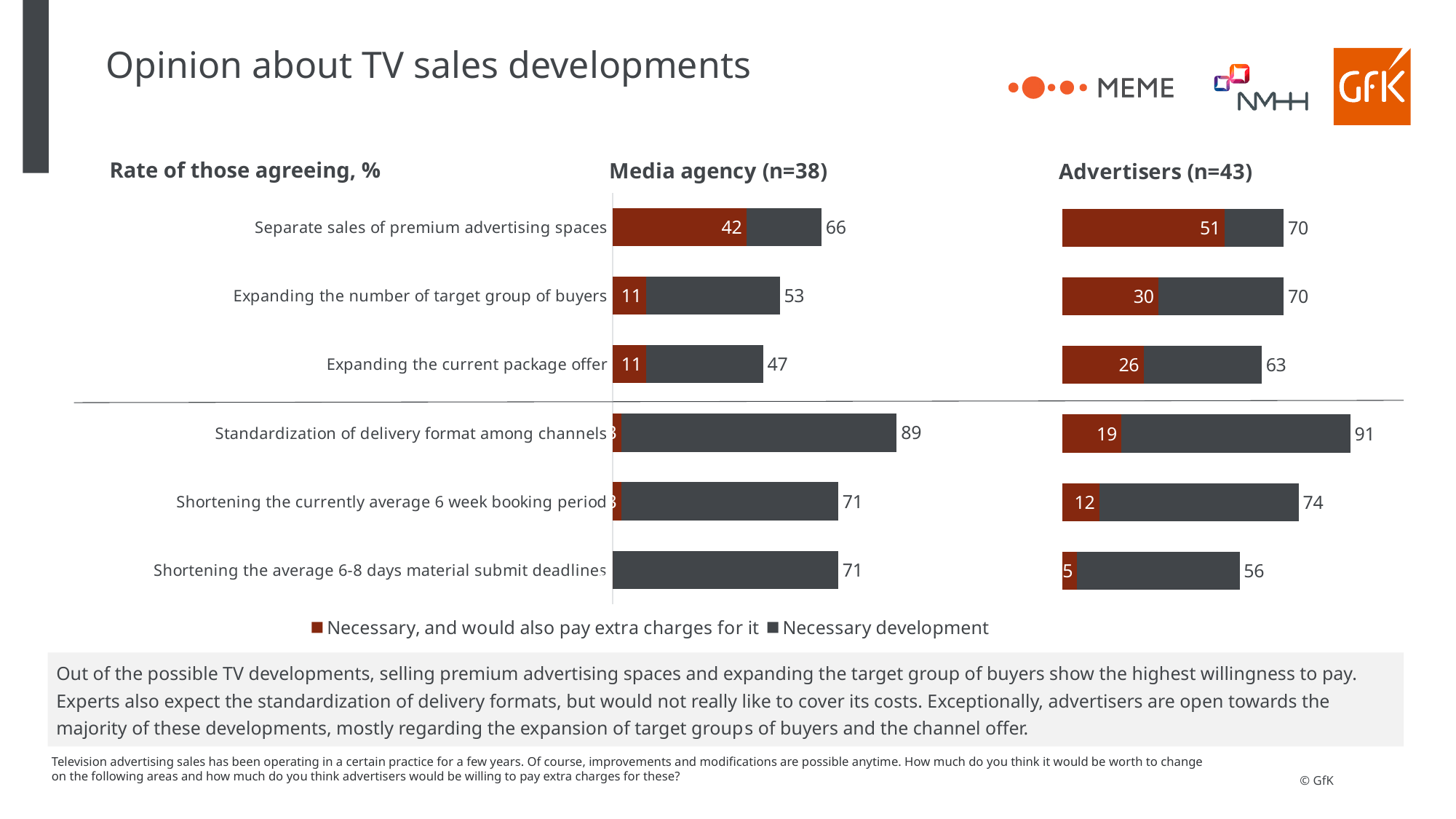
In the Advertisers (n=43) chart, which category has the lowest 'Necessary, and would also pay extra charges for it' value? Shortening the average 6-8 days material submit deadlines Which is larger: the value at the end of the bar for 'Shortening the currently average 6 week booking period' in the Media agency (n=38) chart or in the Advertisers (n=43) chart? Advertisers (n=43) In the Media agency (n=38) chart, what is the 'Necessary, and would also pay extra charges for it' value for 'Separate sales of premium advertising spaces'? 42 How many series does the legend list? 2 In the Advertisers (n=43) chart, what value is printed at the end of the bar for 'Standardization of delivery format among channels'? 91 What is the difference between the 'Necessary, and would also pay extra charges for it' values for 'Separate sales of premium advertising spaces' in the Advertisers (n=43) chart and the Media agency (n=38) chart? 9 What is the sample size shown in the title of the Advertisers chart? n=43 In the Advertisers (n=43) chart, what is the 'Necessary, and would also pay extra charges for it' value for 'Expanding the number of target group of buyers'? 30 In the Advertisers (n=43) chart, which category has the highest 'Necessary, and would also pay extra charges for it' value? Separate sales of premium advertising spaces How many categories are shown in the Media agency (n=38) chart? 6 What kind of chart is used on this slide? bar chart In the Media agency (n=38) chart, what value is printed at the end of the bar for 'Expanding the current package offer'? 47